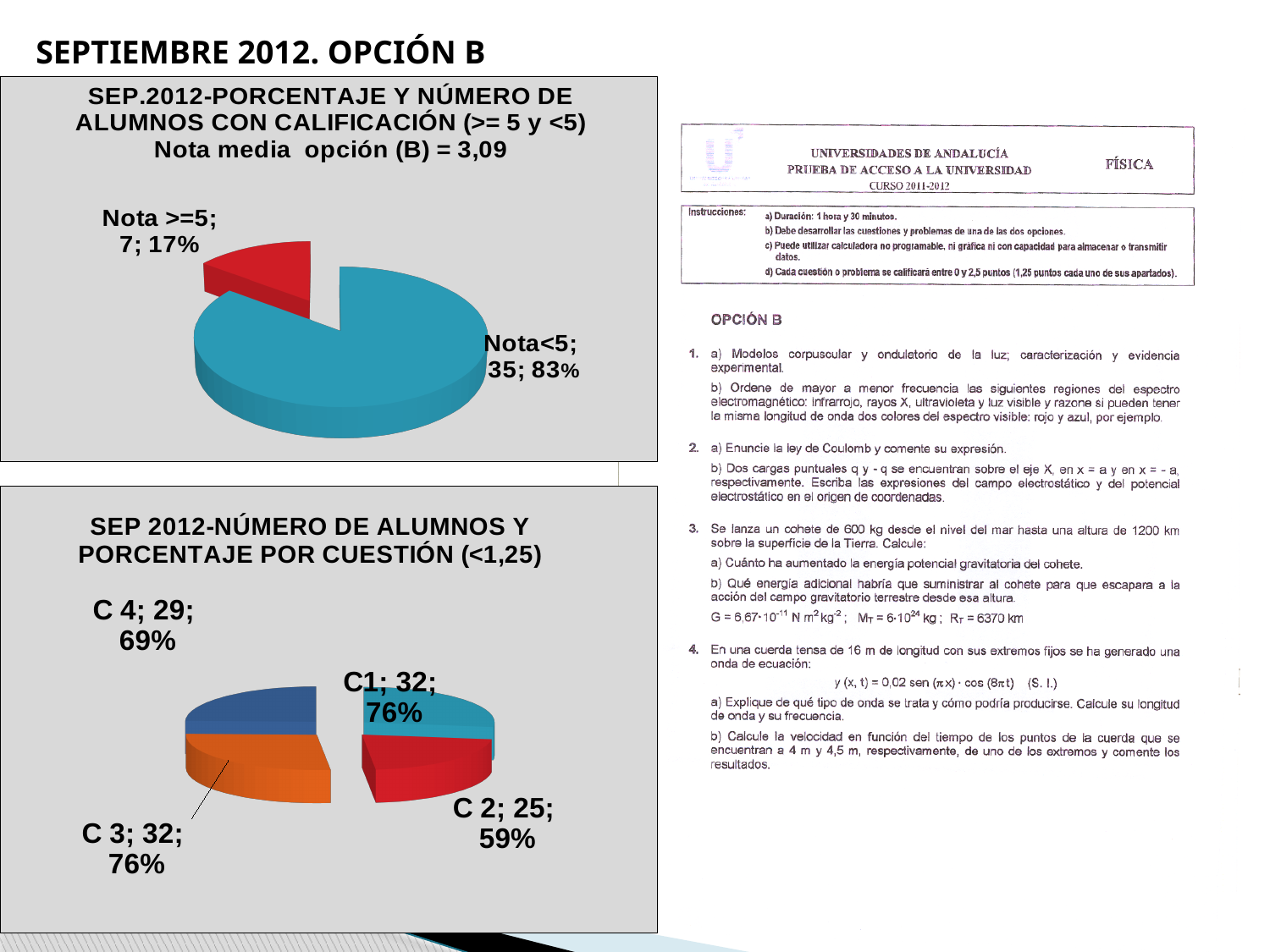
In the top pie chart, how many students have Nota<5? 35 In the bottom pie chart, what is the difference in number of students between C1 and C 2? 7 According to the top chart's title, what is the nota media for opción B? 3,09 In the bottom pie chart, what percentage is shown for C 4? 69% In the top pie chart, what is the difference in number of students between Nota<5 and Nota >=5? 28 In the top pie chart, which category has the larger slice, Nota >=5 or Nota<5? Nota<5 In the top pie chart, what percentage of students have Nota<5? 83% In the bottom pie chart, which cuestión has the lowest number of students? C 2 In the bottom pie chart, how many students are shown for C 2? 25 How many slices does the bottom pie chart have? 4 What type of chart is the top chart on the slide? Pie chart In the top pie chart, how many students have Nota >=5? 7